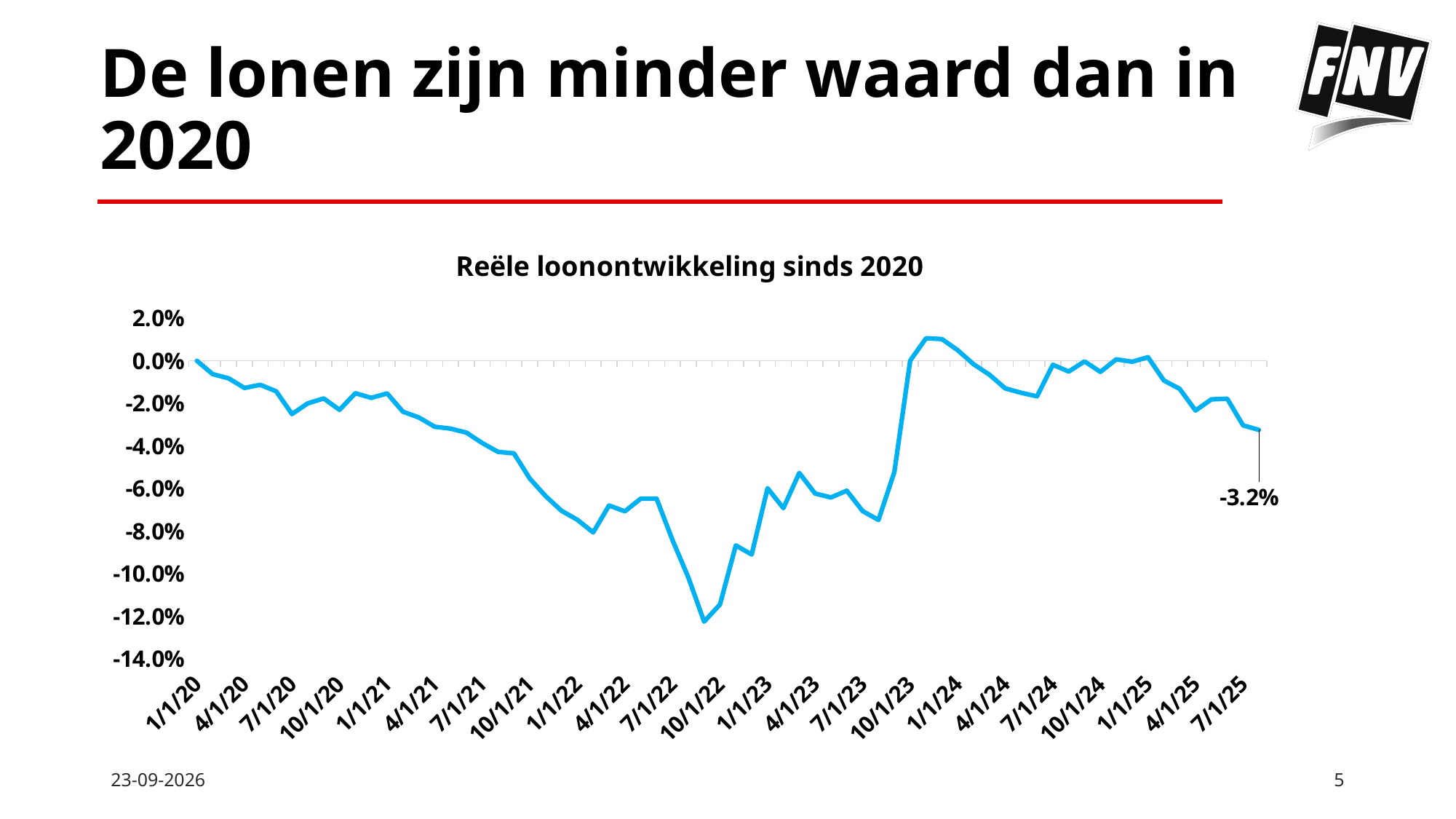
Is the value around 10/1/22 greater or less than -10.0%? less What is the title of the chart? Reële loonontwikkeling sinds 2020 Around which date does the line reach its highest point? 1/1/24 Is the value at 7/1/25 greater or less than -2.0%? less Does the line rise or fall between 1/1/25 and 7/1/25? fall What kind of chart is shown on the slide? line chart What value is labelled at the end of the line, at 7/1/25? -3.2% Does the line rise or fall between 10/1/22 and 1/1/24? rise What is the value at the start of the line, at 1/1/20? 0.0% Is the value around 1/1/24 greater or less than 0.0%? greater Which is larger, the value at 1/1/22 or the value at 1/1/24? 1/1/24 Around which date does the line reach its lowest point? 10/1/22